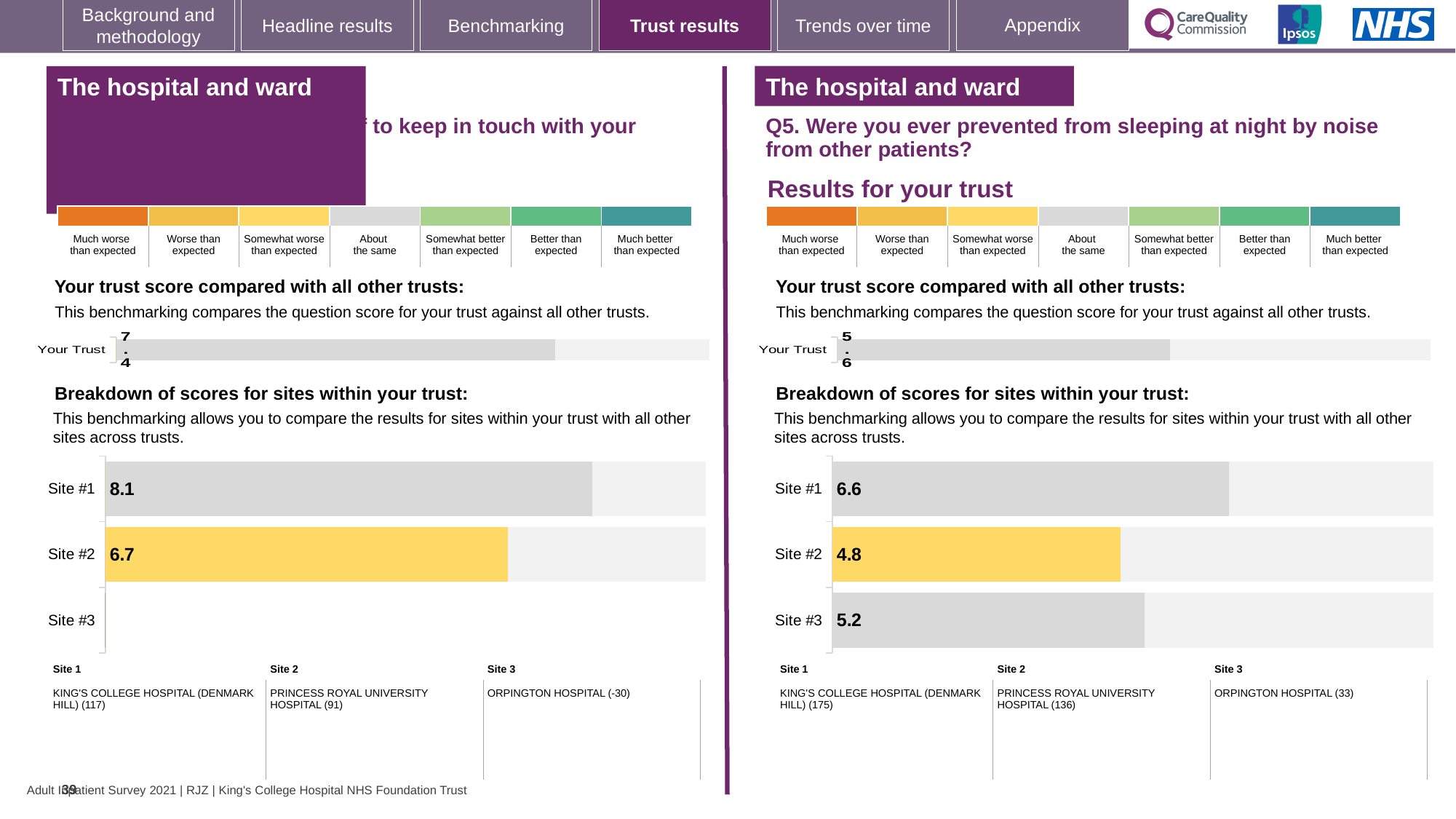
On the right-hand site breakdown chart (Q5), which site has the lowest score? Site #2 On the left-hand site breakdown chart, what is the difference between the scores for Site #1 and Site #2? 1.4 On the right-hand chart (Q5, noise from other patients), what is the score for Site #2? 4.8 On the left-hand site breakdown chart, what is the score for Site #2? 6.7 On the right-hand site breakdown chart (Q5), which site has the highest score? Site #1 On the left-hand site breakdown chart, what is the score for Site #1? 8.1 On the left-hand 'Your trust score compared with all other trusts' chart, what is the score for Your Trust? 7.4 On the right-hand chart (Q5, noise from other patients), what is the score for Site #3? 5.2 What kind of chart is used for the site breakdown on the right-hand side of the slide? Bar chart On the right-hand chart (Q5, noise from other patients), what is the score for Site #1? 6.6 On the right-hand site breakdown chart (Q5), what is the difference between the scores for Site #1 and Site #2? 1.8 On the right-hand 'Your trust score compared with all other trusts' chart (Q5), what is the score for Your Trust? 5.6